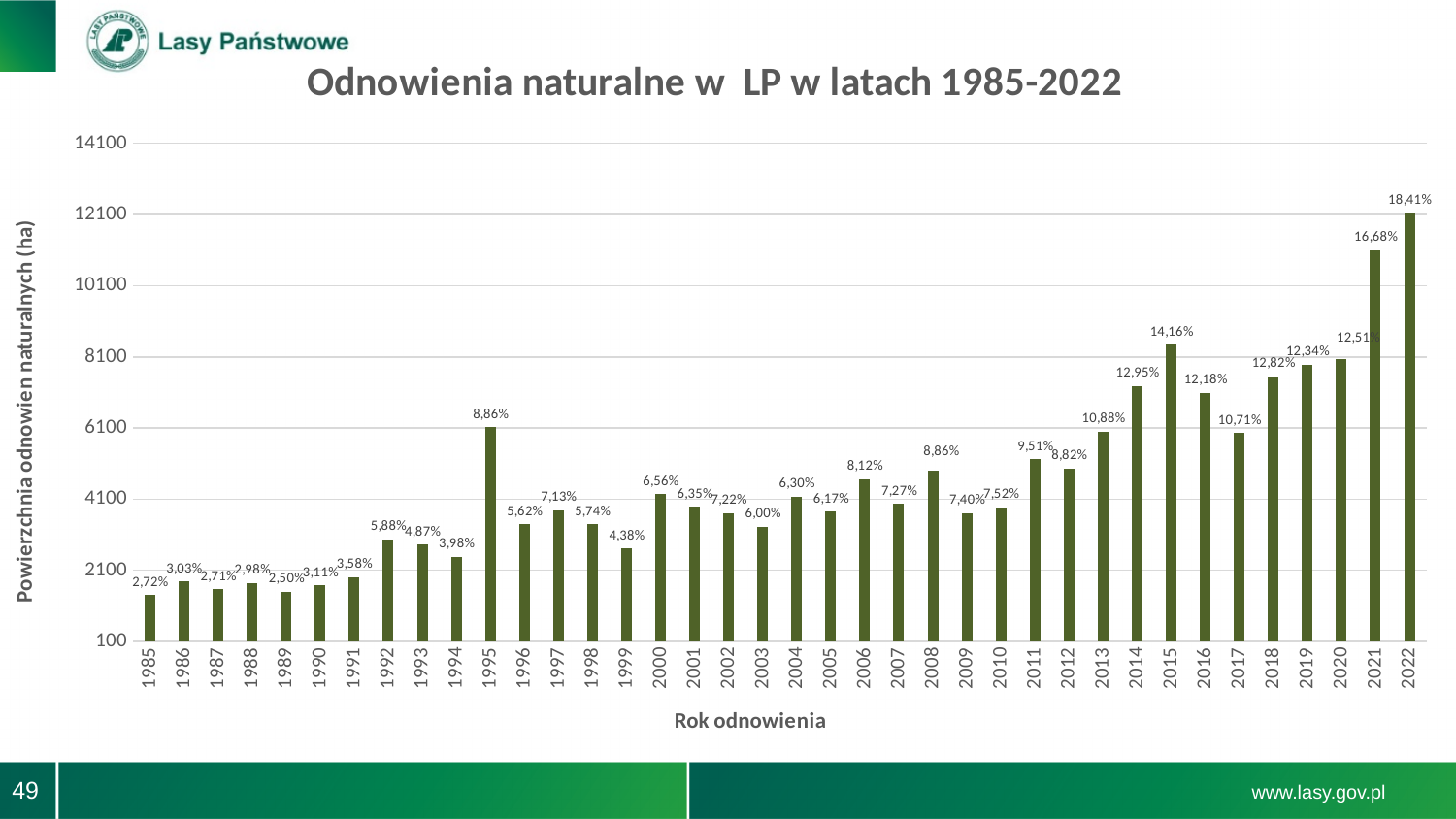
Is the bar for 2021 greater or less than 10100 ha? greater Which year has the lowest percentage label on the chart? 1989 What percentage label is shown for the year 1989? 2,50% Which year has the tallest bar on the chart? 2022 Is the bar for 2014 greater or less than 6100 ha? greater What percentage label is shown for the year 1995? 8,86% What is the title of the x axis? Rok odnowienia What kind of chart is shown on the slide? bar chart What percentage label is shown for the year 2015? 14,16% How many years (bars) are plotted on the chart? 38 Which year has the higher percentage label, 2006 or 2008? 2008 What is the difference between the percentage labels for 2022 and 2021? 1,73 percentage points